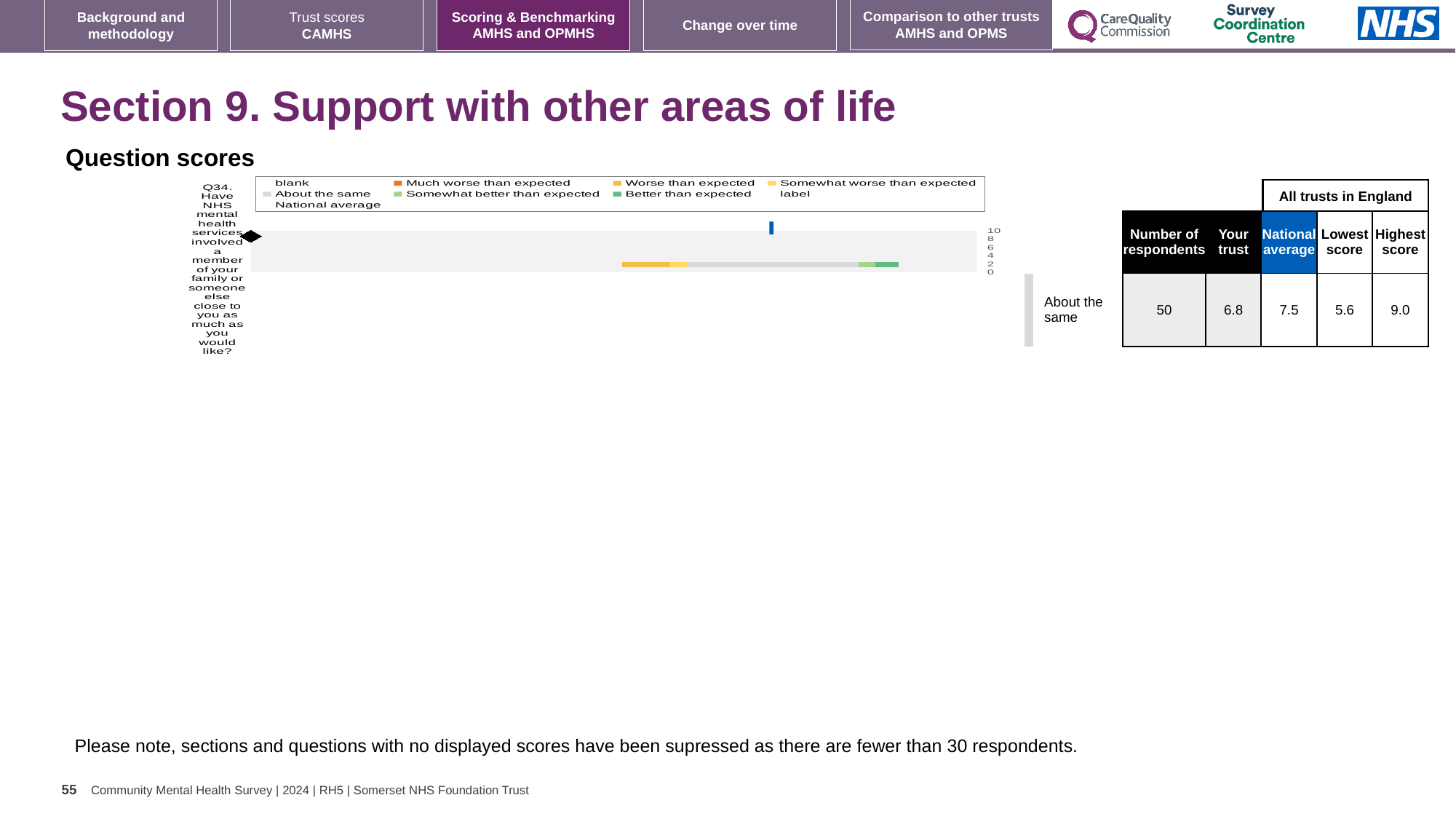
In the table beside the Question scores chart, what is the number of respondents for Q34? 50 In the Question scores chart, is the National average marker for Q34 greater or less than 10? less What is the highest value shown on the score axis of the Question scores chart? 10 In the table beside the Question scores chart, what is the 'Your trust' score for Q34? 6.8 In the table beside the Question scores chart, what is the National average for Q34? 7.5 In the table beside the Question scores chart, which is larger for Q34: the 'Your trust' score or the National average? National average Which question is plotted in the Question scores chart? Q34. Have NHS mental health services involved a member of your family or someone else close to you as much as you would like? How many questions (categories) are plotted in the Question scores chart? 1 In the table beside the Question scores chart, what is the highest score among all trusts in England for Q34? 9.0 In the Question scores chart, is the National average marker for Q34 greater or less than 6? greater What kind of chart is shown under 'Question scores'? bar chart In the table beside the Question scores chart, what is the difference between the highest score (9.0) and the lowest score (5.6) for Q34? 3.4